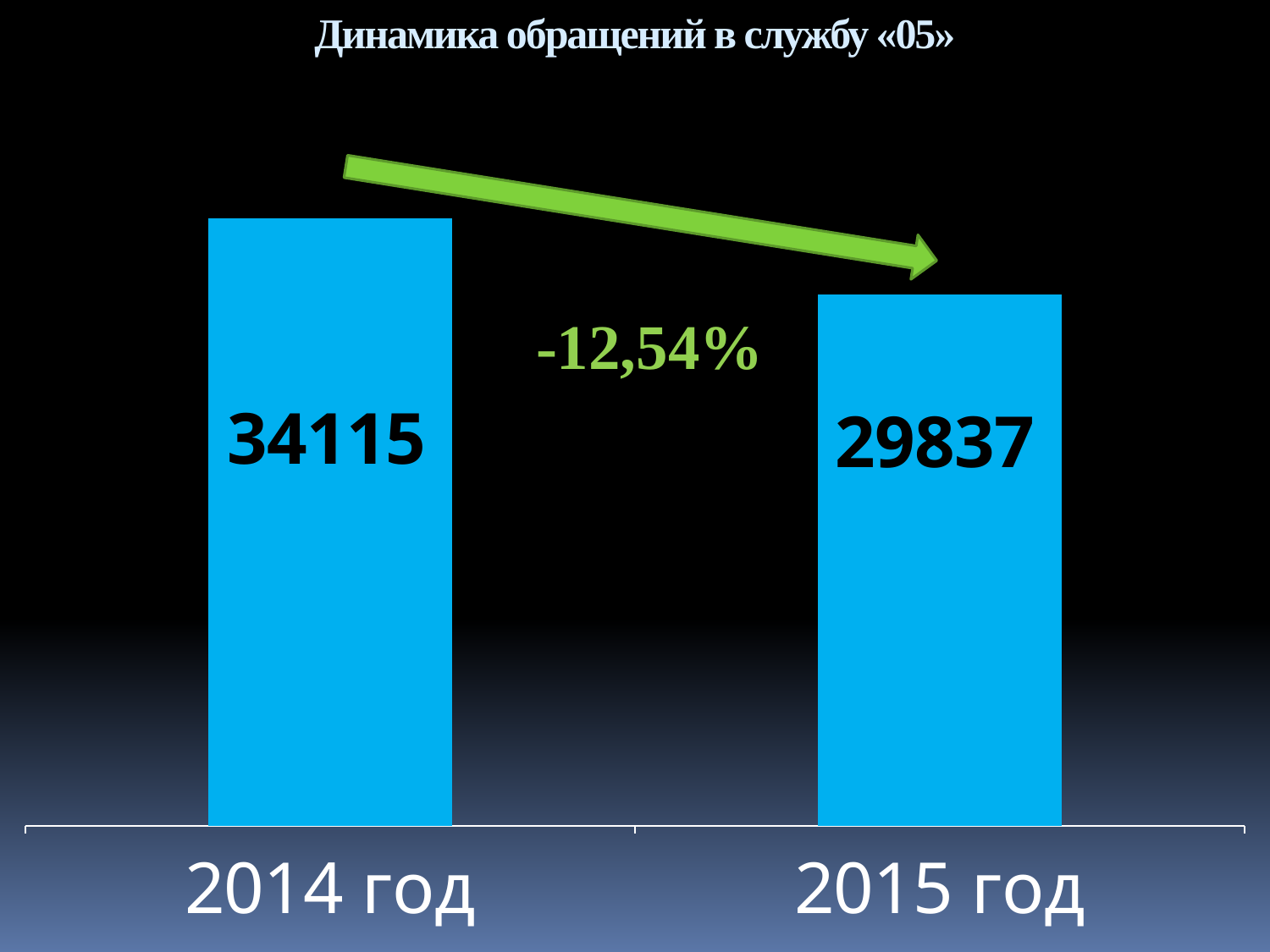
How many categories are shown on the x axis? 2 Which year has the highest value? 2014 год What is the value for 2015 год? 29837 What is the difference between the values for 2014 год and 2015 год? 4278 Do the values rise or fall from 2014 год to 2015 год? fall What kind of chart is shown on the slide? bar chart Which year has the lowest value? 2015 год What is the value for 2014 год? 34115 What percentage change is printed between the two bars? -12,54% What is the title of the chart? Динамика обращений в службу «05» Which is larger, the value for 2014 год or the value for 2015 год? 2014 год